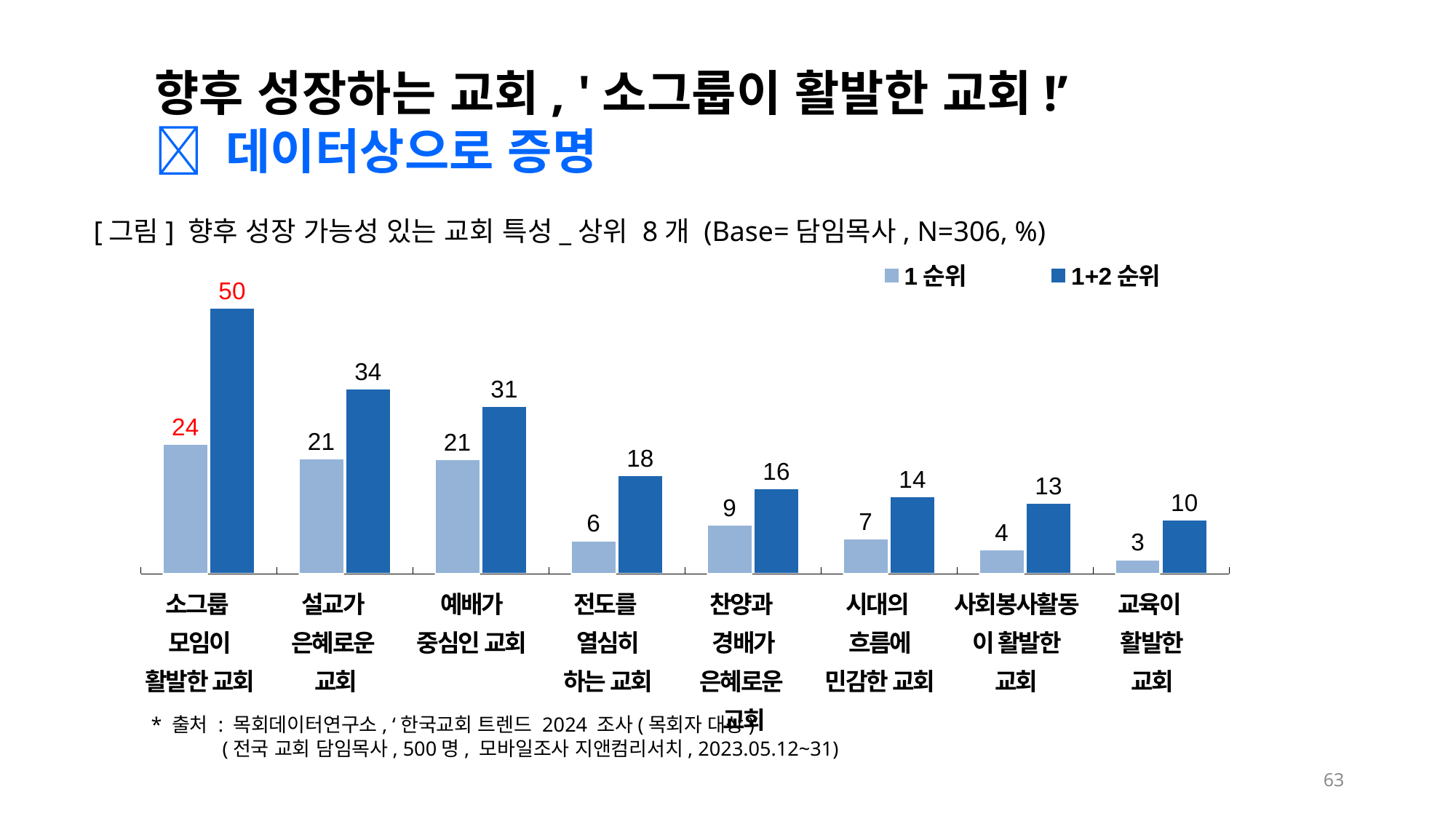
How many series does the legend list? 2 What is the '1+2 순위' value for '전도를 열심히 하는 교회'? 18 Which category has the highest '1+2 순위' value? 소그룹 모임이 활발한 교회 What is the '1 순위' value for '교육이 활발한 교회'? 3 Which is larger: the '1+2 순위' value for '설교가 은혜로운 교회' or for '예배가 중심인 교회'? 설교가 은혜로운 교회 What kind of chart is shown on the slide? Bar chart What is the '1 순위' value for '설교가 은혜로운 교회'? 21 How many categories are shown on the x axis of the chart? 8 What is the difference between the '1+2 순위' and '1 순위' values for '소그룹 모임이 활발한 교회'? 26 What is the '1+2 순위' value for '소그룹 모임이 활발한 교회'? 50 Do the '1+2 순위' values rise or fall from left to right along the x axis? Fall Which category has the lowest '1 순위' value? 교육이 활발한 교회